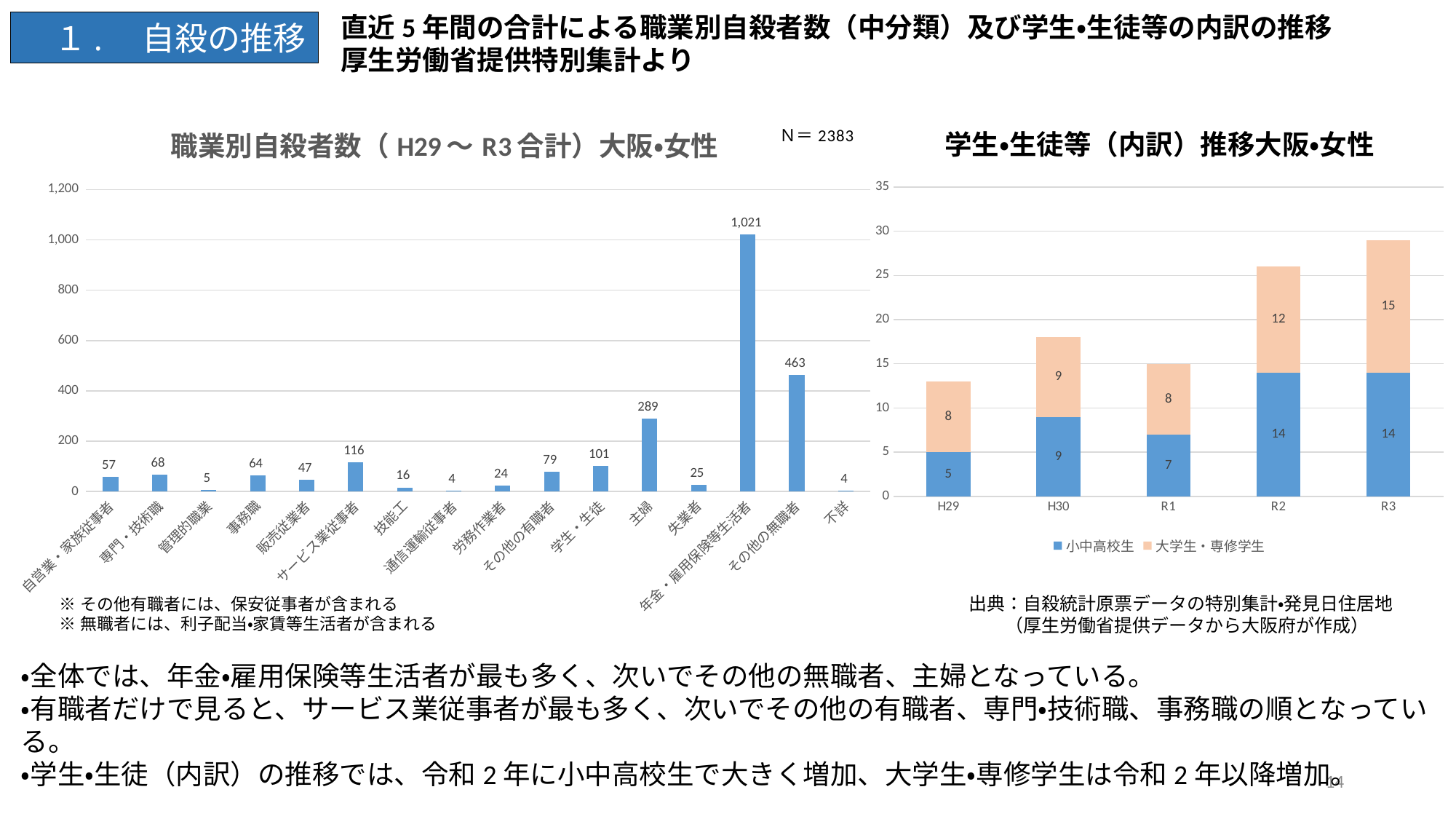
In the right chart (学生・生徒等（内訳）推移大阪・女性), what is the total of the stacked bar for R2? 26 In the left chart (職業別自殺者数（H29～R3合計）大阪・女性), how many occupation categories are shown on the x axis? 16 In the left chart (職業別自殺者数（H29～R3合計）大阪・女性), which category has the highest value? 年金・雇用保険等生活者 In the right chart (学生・生徒等（内訳）推移大阪・女性), what is the value for 大学生・専修学生 in R3? 15 In the right chart (学生・生徒等（内訳）推移大阪・女性), how many series does the legend list? 2 In the left chart (職業別自殺者数（H29～R3合計）大阪・女性), what is the value for 年金・雇用保険等生活者? 1,021 In the left chart (職業別自殺者数（H29～R3合計）大阪・女性), which is larger, 専門・技術職 or 事務職? 専門・技術職 What kind of chart is the left chart (職業別自殺者数（H29～R3合計）大阪・女性)? Bar chart In the right chart (学生・生徒等（内訳）推移大阪・女性), which year has the lowest value for 小中高校生? H29 In the left chart (職業別自殺者数（H29～R3合計）大阪・女性), what is the value for サービス業従事者? 116 In the right chart (学生・生徒等（内訳）推移大阪・女性), which colour represents 大学生・専修学生? Orange In the left chart (職業別自殺者数（H29～R3合計）大阪・女性), what is the difference between その他の無職者 and 主婦? 174